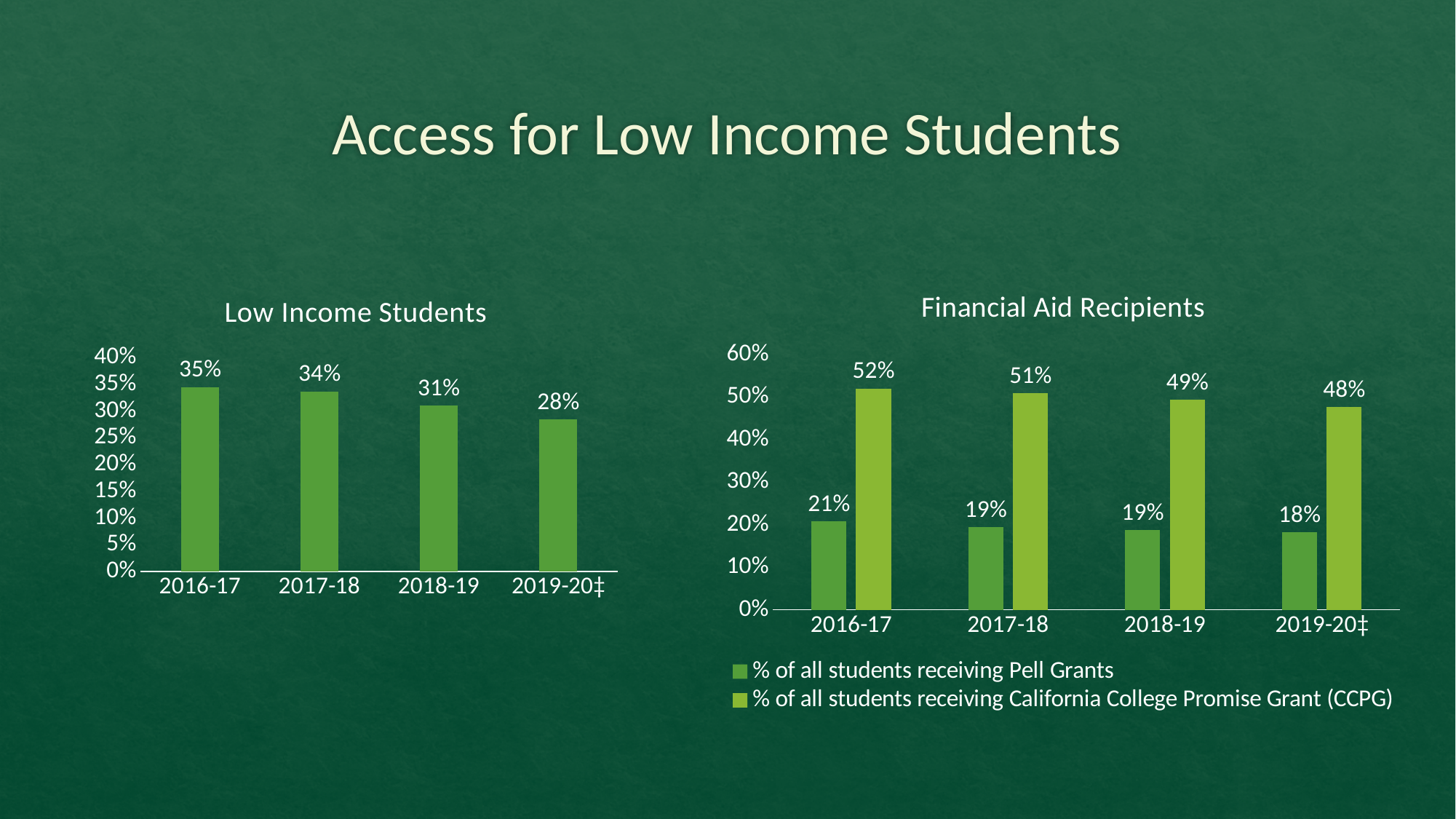
In the 'Low Income Students' chart, what is the value for 2016-17? 35% How many series does the legend of the 'Financial Aid Recipients' chart list? 2 In the 'Low Income Students' chart, what is the difference between the 2016-17 and 2019-20‡ values? 7% In the 'Low Income Students' chart, do the values rise or fall from 2016-17 to 2019-20‡? fall In the 'Low Income Students' chart, which year has the lowest value? 2019-20‡ In the 'Low Income Students' chart, how many years are shown? 4 In the 'Financial Aid Recipients' chart, what is the difference between the CCPG and Pell Grant values in 2016-17? 31% In the 'Financial Aid Recipients' chart, what percentage of all students received Pell Grants in 2017-18? 19% In the 'Financial Aid Recipients' chart, which year has the highest CCPG value? 2016-17 What kind of chart is the 'Financial Aid Recipients' chart? bar chart In the 'Financial Aid Recipients' chart, what percentage of all students received the California College Promise Grant (CCPG) in 2018-19? 49% In the 'Financial Aid Recipients' chart, which is larger in 2019-20‡: the Pell Grants value or the CCPG value? CCPG